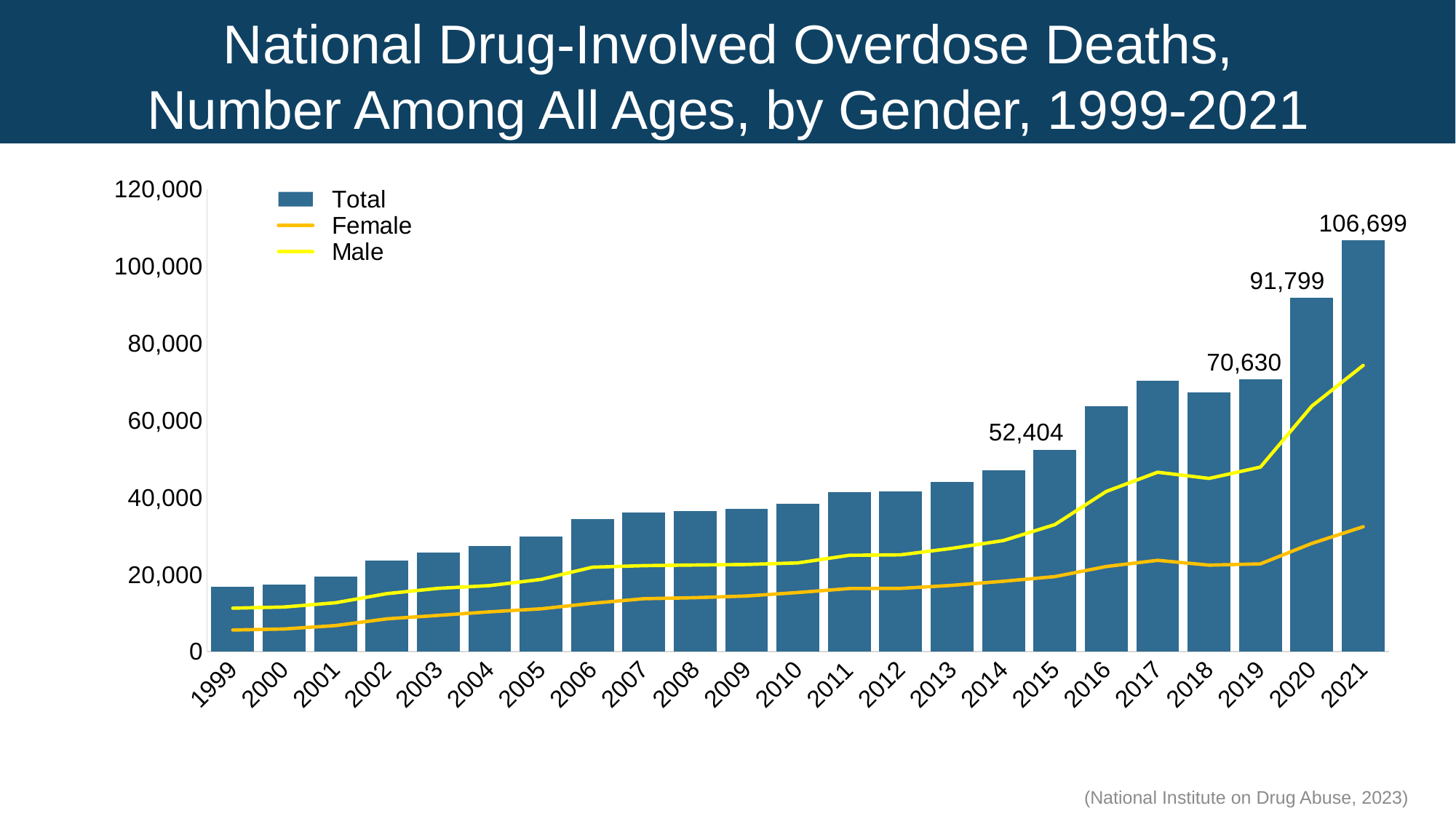
What is the Total number of drug-involved overdose deaths in 2019? 70,630 What is the Total number of drug-involved overdose deaths in 2020? 91,799 Which year has the lowest Total number of overdose deaths? 1999 What is the Total number of drug-involved overdose deaths in 2021? 106,699 Is the Male value for 2021 greater or less than 60,000? greater Which year has the highest Total number of overdose deaths? 2021 What is the Total number of drug-involved overdose deaths in 2015? 52,404 How many years are shown on the x axis? 23 How many series does the legend list? 3 By how much did the Total number of overdose deaths increase from 2020 to 2021? 14,900 Is the Female value for 2021 greater or less than 40,000? less Which year has a larger Total number of overdose deaths, 2019 or 2020? 2020